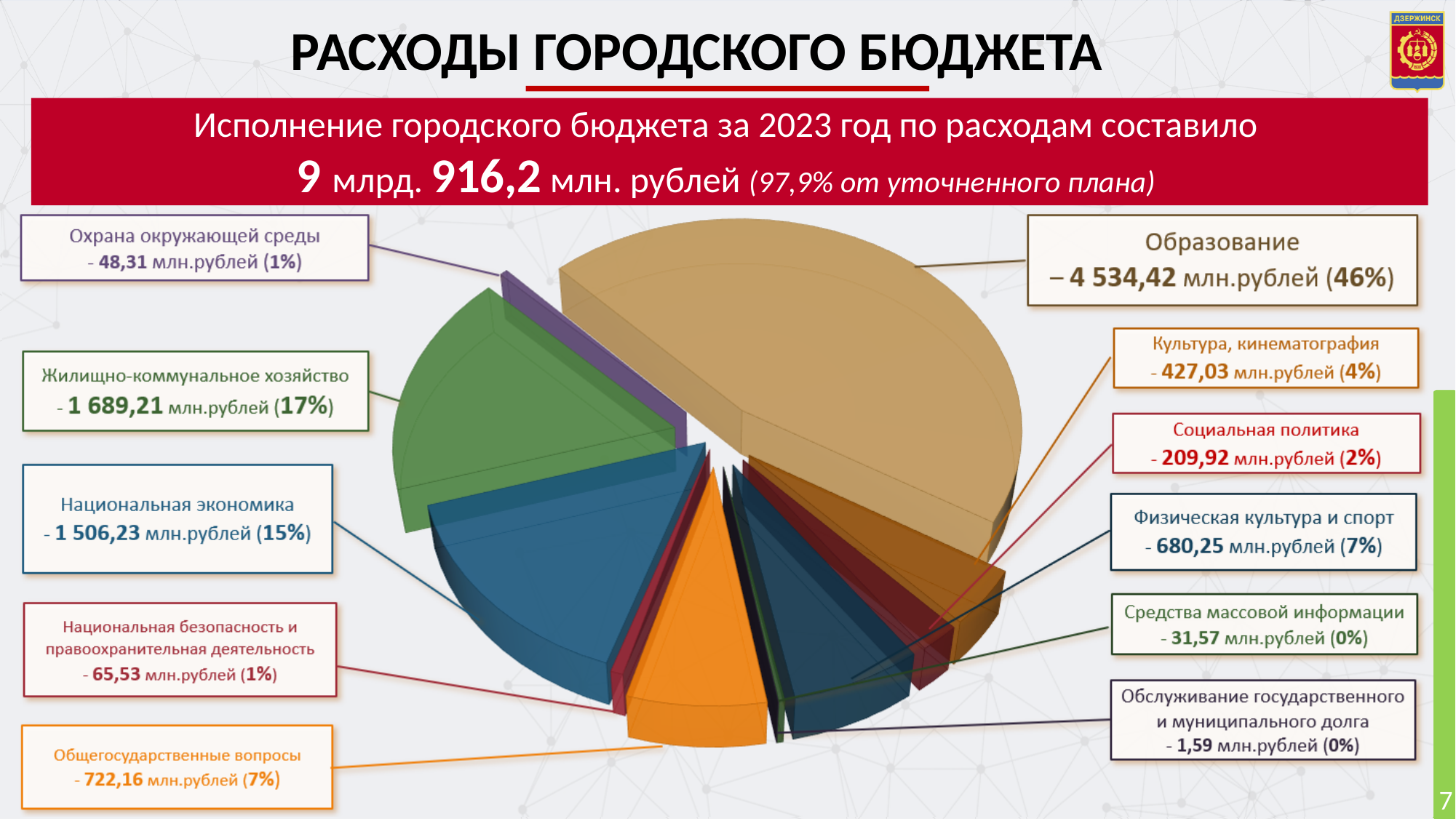
What is the value for Жилищно-коммунальное хозяйство? 1 689,21 млн.рублей What is the value for Средства массовой информации? 31,57 млн.рублей Which category has the largest share of the budget expenditures? Образование Which is larger: Общегосударственные вопросы or Физическая культура и спорт? Общегосударственные вопросы What is the title of the slide containing the chart? РАСХОДЫ ГОРОДСКОГО БЮДЖЕТА What is the value for Образование? 4 534,42 млн.рублей What share of the pie does Национальная экономика represent? 15% Which category has the smallest value? Обслуживание государственного и муниципального долга What is the difference between Жилищно-коммунальное хозяйство and Национальная экономика? 182,98 млн.рублей How many expenditure categories are shown in the pie chart? 11 What type of chart is shown on the slide? Pie chart What share of the pie does Образование represent? 46%